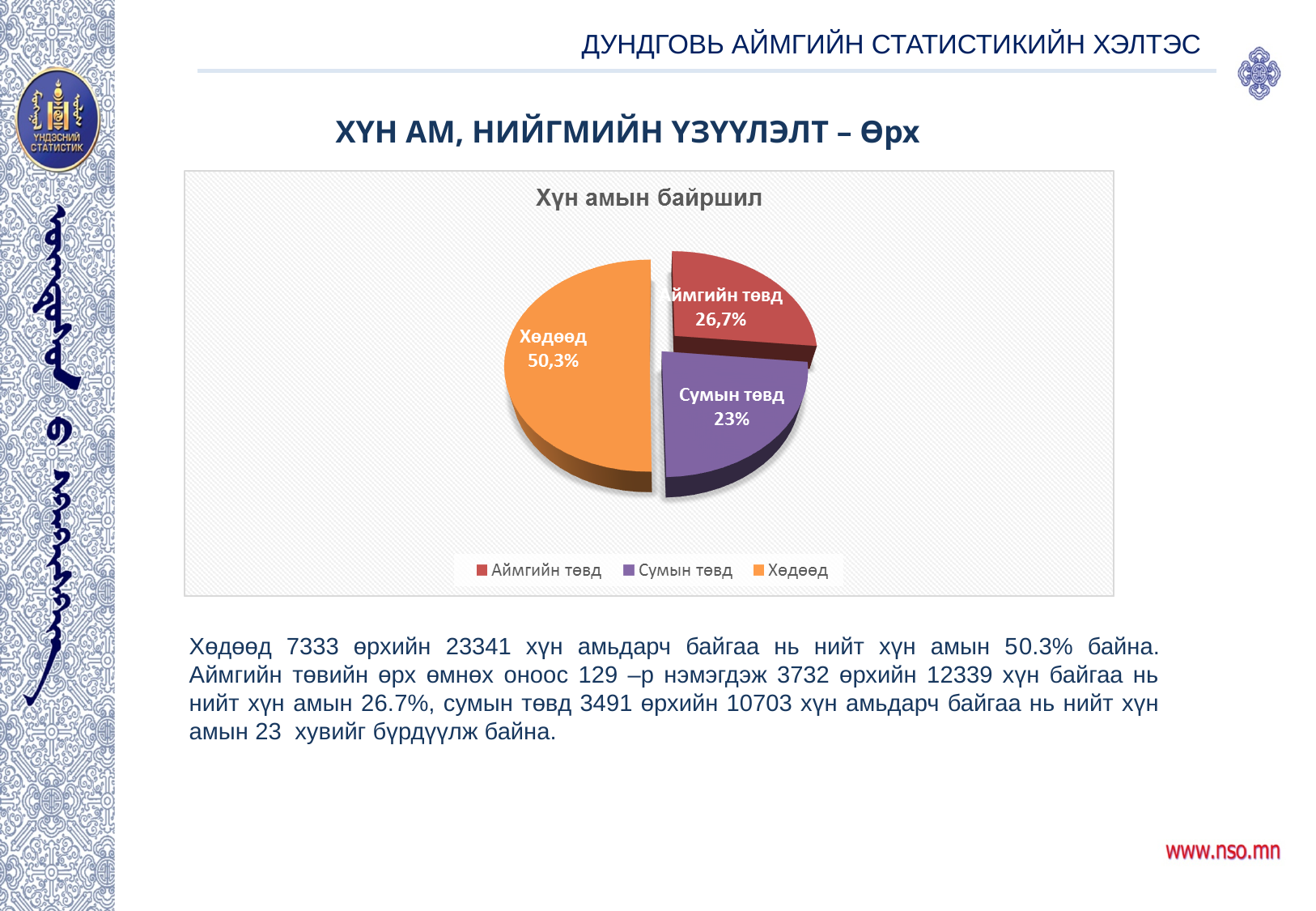
Which slice of the pie is the smallest? Сумын төвд How many slices does the pie chart have? 3 How many entries does the legend list? 3 What share of the pie does Сумын төвд have? 23% What share of the pie does Аймгийн төвд have? 26,7% What is the difference between the share for Хөдөөд and the share for Аймгийн төвд? 23,6% What share of the pie does Хөдөөд have? 50,3% Which slice of the pie is the largest? Хөдөөд What type of chart is shown on the slide? Pie chart Which is larger, the share for Аймгийн төвд or the share for Сумын төвд? Аймгийн төвд What colour is the Хөдөөд slice in the pie chart? Orange What is the title of the chart? Хүн амын байршил